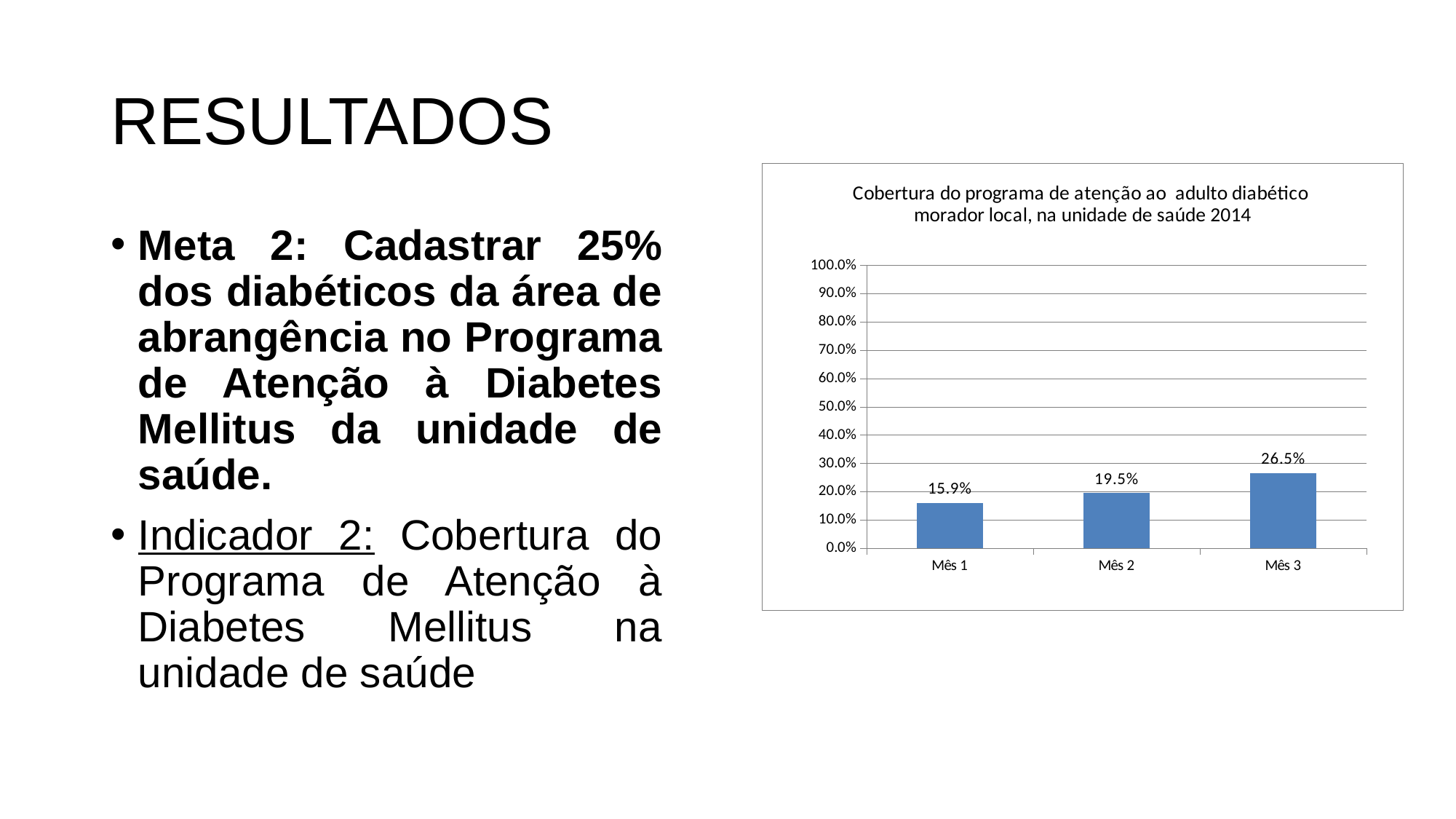
What is the value for Mês 3? 26.5% How many months are shown on the x axis? 3 What kind of chart is shown on the slide? Bar chart What is the difference between the values for Mês 2 and Mês 1? 3.6% Which month has the highest coverage value? Mês 3 What is the value for Mês 2? 19.5% What is the difference between the values for Mês 3 and Mês 1? 10.6% What is the value for Mês 1? 15.9% Do the values rise or fall from Mês 1 to Mês 3? Rise Is the value for Mês 3 greater or less than 20.0%? greater Which is larger, the value for Mês 2 or the value for Mês 3? Mês 3 Which month has the lowest coverage value? Mês 1